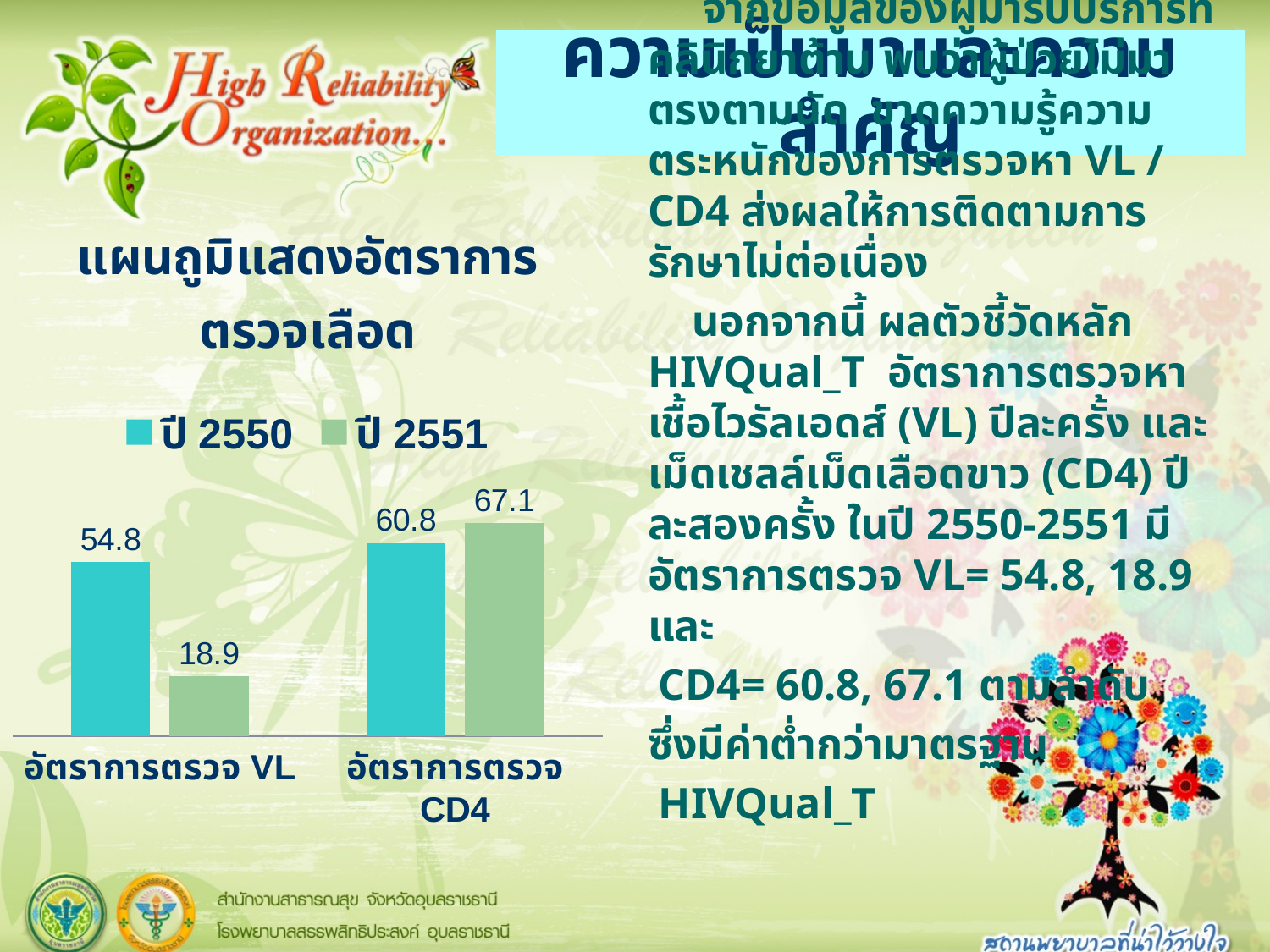
What is the value for อัตราการตรวจ CD4 in ปี 2550? 60.8 What is the difference between the ปี 2551 and ปี 2550 values for อัตราการตรวจ CD4? 6.3 For อัตราการตรวจ CD4, which year has the larger value, ปี 2550 or ปี 2551? ปี 2551 What is the value for อัตราการตรวจ VL in ปี 2551? 18.9 How many series does the legend list? 2 What is the value for อัตราการตรวจ VL in ปี 2550? 54.8 What type of chart is shown on the slide? bar chart What is the value for อัตราการตรวจ CD4 in ปี 2551? 67.1 What is the difference between the ปี 2550 and ปี 2551 values for อัตราการตรวจ VL? 35.9 Which bar has the lowest value in the chart? อัตราการตรวจ VL, ปี 2551 Which bar has the highest value in the chart? อัตราการตรวจ CD4, ปี 2551 How many categories are shown on the x axis of the chart? 2